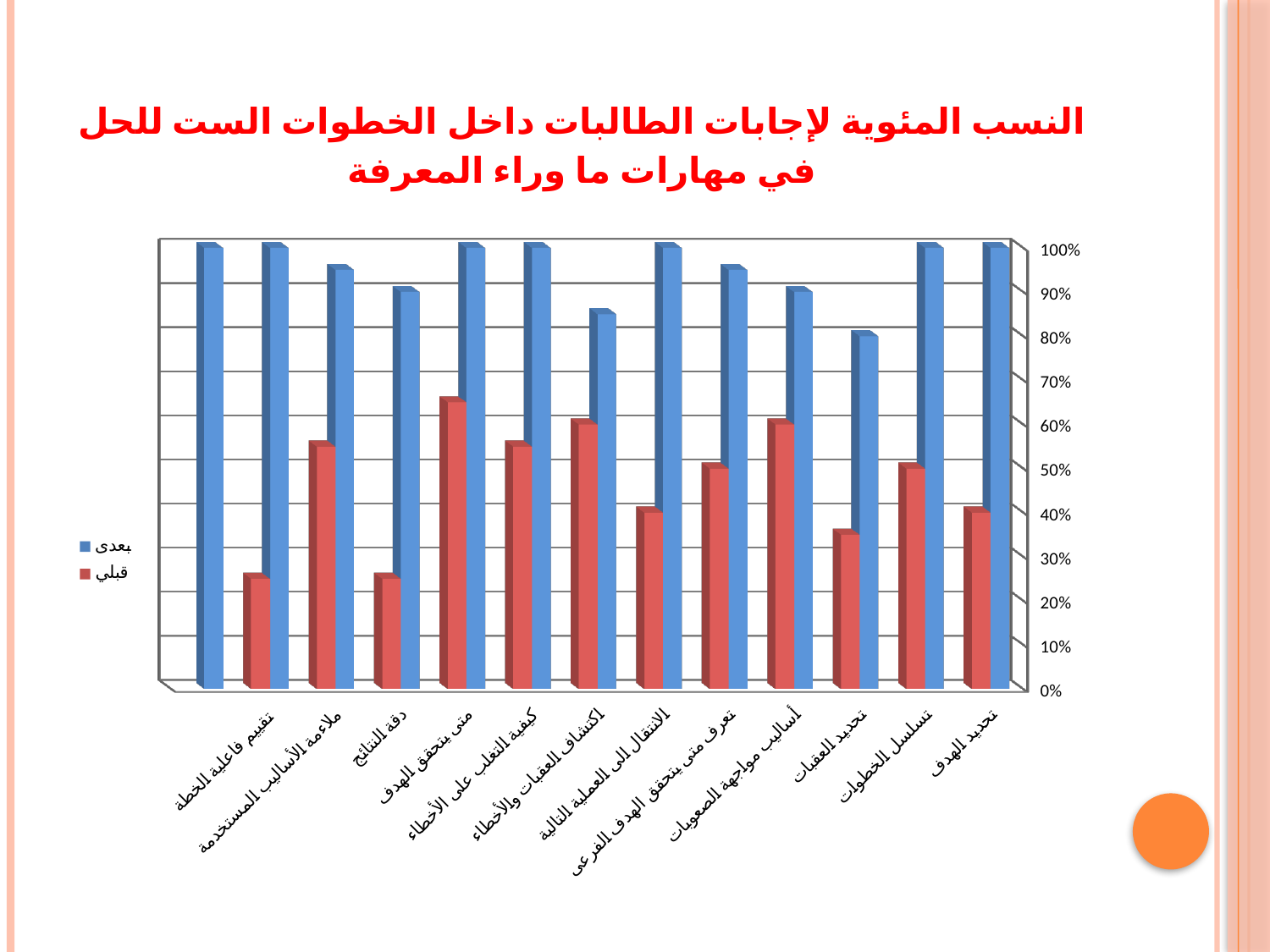
What kind of chart is shown on the slide? bar chart Is the قبلي value for تحديد العقبات greater or less than 40%? less Which is larger for تحديد الهدف, the بعدى value or the قبلي value? بعدى Is the بعدى value for تحديد العقبات greater or less than 90%? less What is the value of the بعدى series for تحديد الهدف? 100% How many series does the legend list? 2 What is the highest value shown on the vertical axis? 100% Which has the larger قبلي value, تسلسل الخطوات or تحديد العقبات? تسلسل الخطوات What is the value of the بعدى series for تسلسل الخطوات? 100% What are the two series named in the legend? بعدى and قبلي Is the قبلي value for أساليب مواجهة الصعوبات greater or less than 50%? greater Which category has the lowest value in the بعدى series? تحديد العقبات